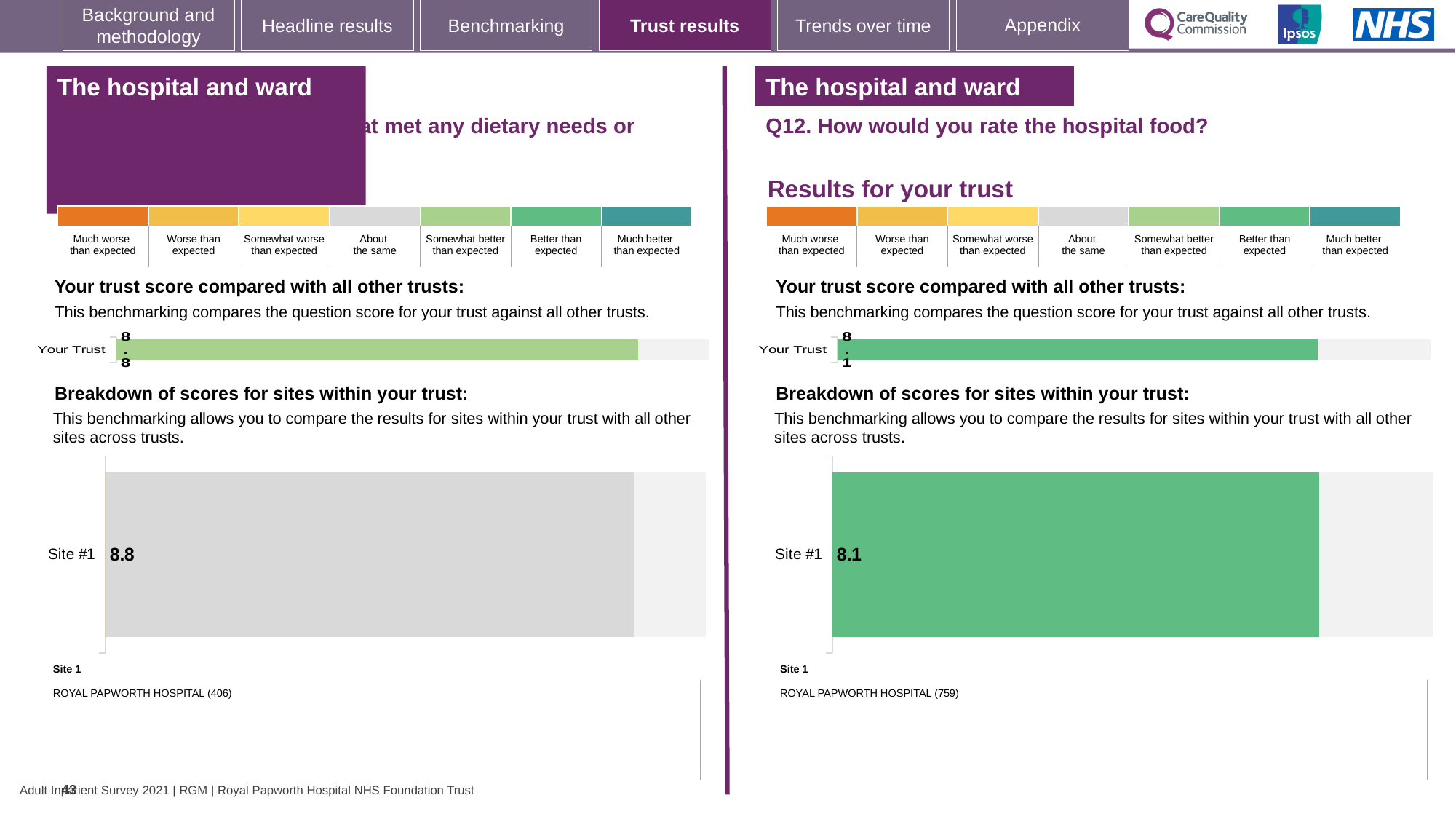
On the right-hand Q12 section, which hospital is listed as Site 1? ROYAL PAPWORTH HOSPITAL (759) On the left-hand chart (dietary needs question), what is the score shown for Your Trust? 8.8 What type of chart is used to show the Your Trust score on the right-hand Q12 section? Bar chart On the right-hand Q12 breakdown of scores for sites within your trust, what is the score for Site #1? 8.1 On the right-hand Q12 chart, what colour is the Your Trust bar? Green On the left-hand breakdown of scores for sites within your trust, what colour is the Site #1 bar? Grey On the left-hand breakdown of scores for sites within your trust, what is the score for Site #1? 8.8 On the right-hand chart for Q12 (How would you rate the hospital food?), what is the score shown for Your Trust? 8.1 On the right-hand Q12 breakdown of scores for sites within your trust, how many sites are shown? 1 Which Your Trust score is higher: the left-hand chart (dietary needs) or the right-hand Q12 chart (hospital food)? Left-hand chart (dietary needs) What is the difference between the Your Trust score on the left-hand chart (8.8) and the Your Trust score on the right-hand Q12 chart (8.1)? 0.7